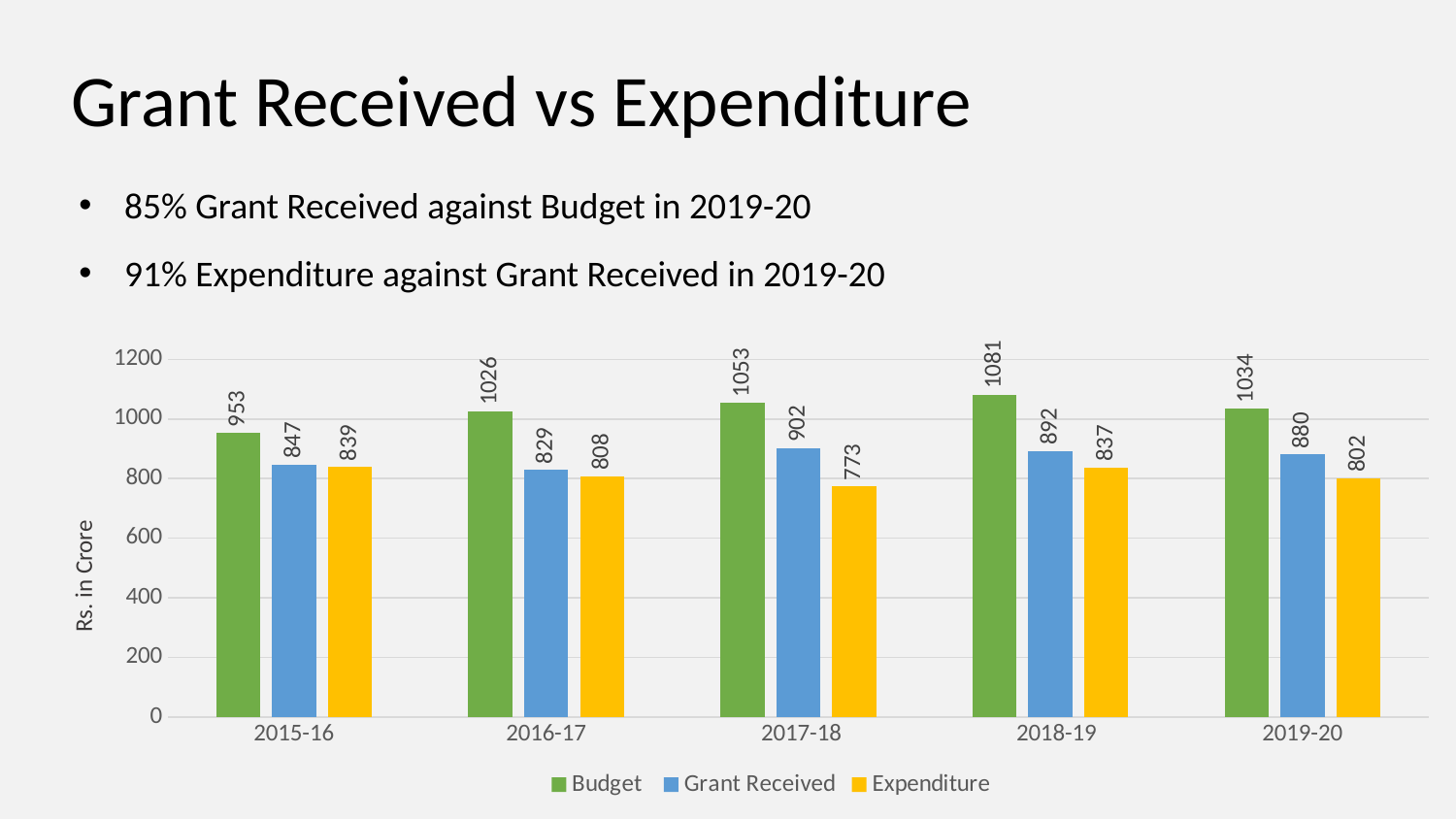
How many years are shown on the x axis? 5 What is the Expenditure value for 2016-17? 808 What is the label on the vertical axis? Rs. in Crore Which is larger in 2015-16: Grant Received or Expenditure? Grant Received What kind of chart is shown on the slide? Bar chart What is the difference between Budget and Grant Received in 2019-20? 154 What is the Budget value for 2017-18? 1053 How many series does the legend list? 3 In which year is the Expenditure lowest? 2017-18 Is the Grant Received value for 2017-18 greater or less than 800? greater What is the Grant Received value for 2019-20? 880 In which year is the Budget highest? 2018-19